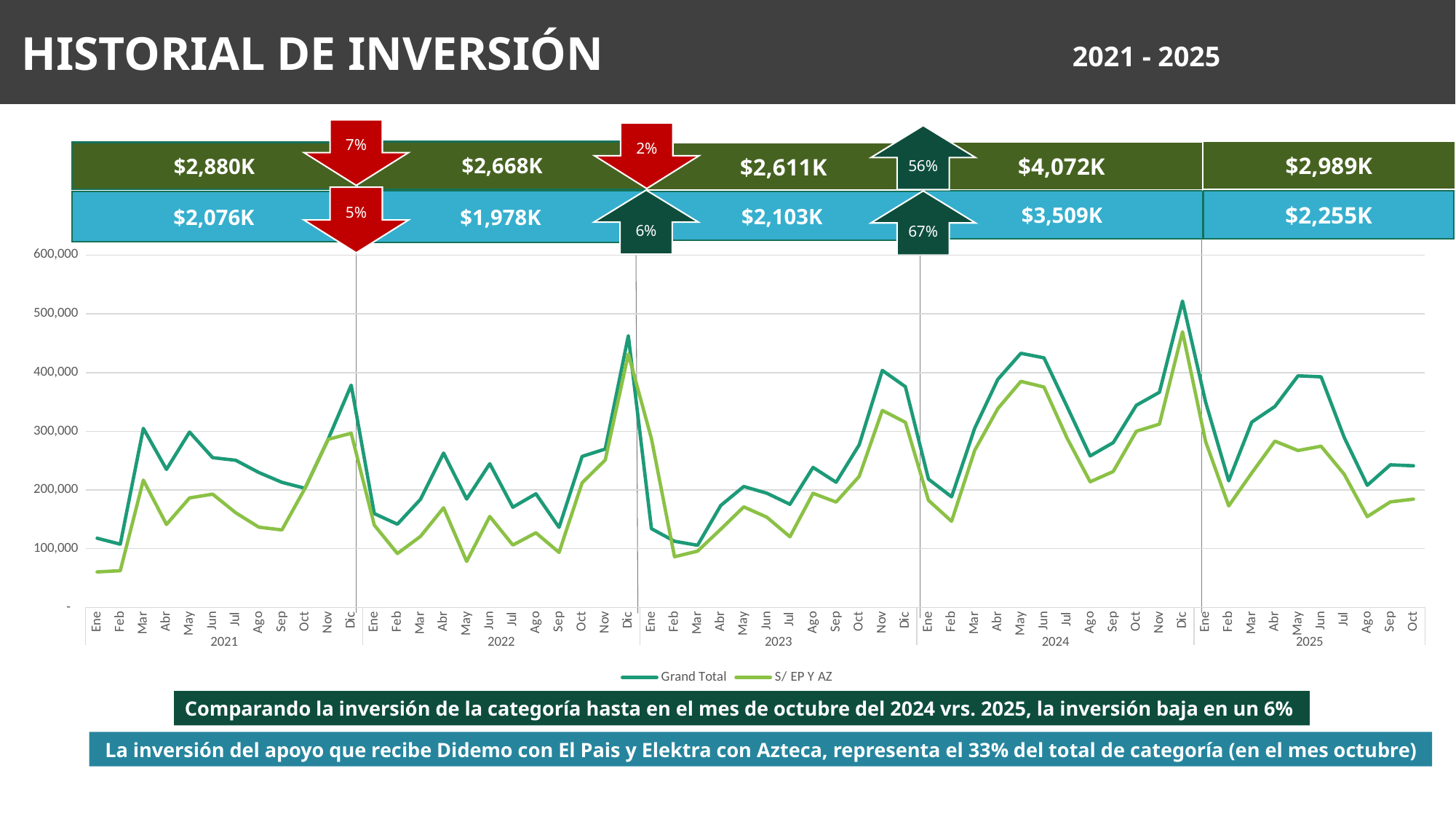
Is the S/ EP Y AZ value for Feb 2021 greater or less than 100,000? less Is the Grand Total value for Dic 2024 greater or less than 500,000? greater Is the Grand Total value for Dic 2022 greater or less than 400,000? greater How many months are plotted for 2025 on the chart? 10 What kind of chart is shown on the slide? line chart What is the annual S/ EP Y AZ total (blue bar) shown for 2022? $1,978K What are the two series named in the chart legend? Grand Total and S/ EP Y AZ Which year has the highest annual Grand Total in the green bars? 2024 Which series is higher in Nov 2023, Grand Total or S/ EP Y AZ? Grand Total How many years are shown along the x axis of the chart? 5 How many series does the chart legend list? 2 What is the annual Grand Total (green bar) shown for 2024? $4,072K